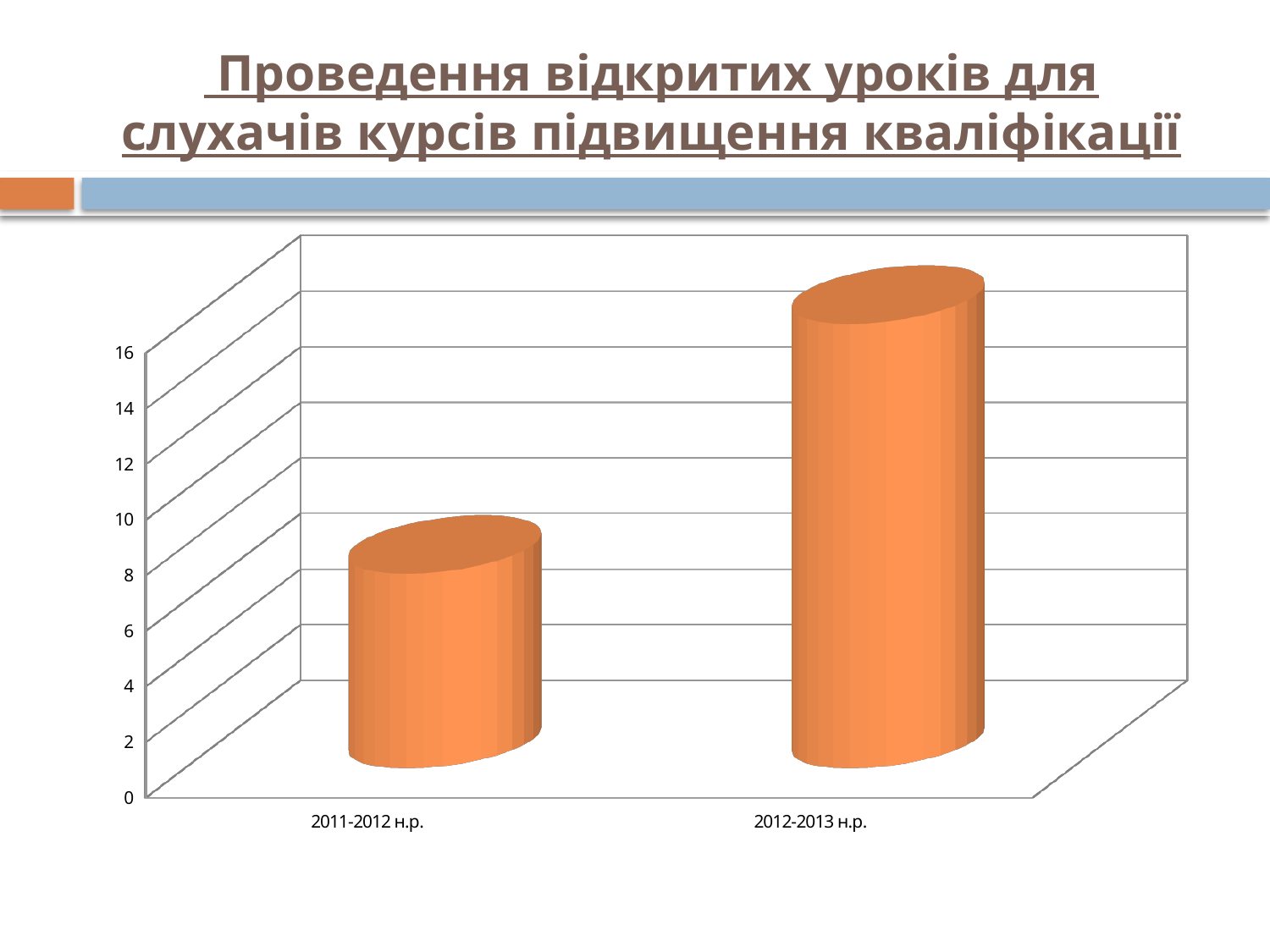
Which category has the highest value in the chart? 2012-2013 н.р. What is the title of the slide containing the chart? Проведення відкритих уроків для слухачів курсів підвищення кваліфікації Is the value for 2011-2012 н.р. greater or less than 10? less Which category has the lowest value in the chart? 2011-2012 н.р. What colour are the bars in the chart? orange Is the value for 2011-2012 н.р. greater or less than 2? greater Which is larger, the value for 2011-2012 н.р. or the value for 2012-2013 н.р.? 2012-2013 н.р. What kind of chart is shown on the slide? bar chart Is the value for 2012-2013 н.р. greater or less than 12? greater Do the values rise or fall from 2011-2012 н.р. to 2012-2013 н.р.? rise How many categories are shown on the x axis of the chart? 2